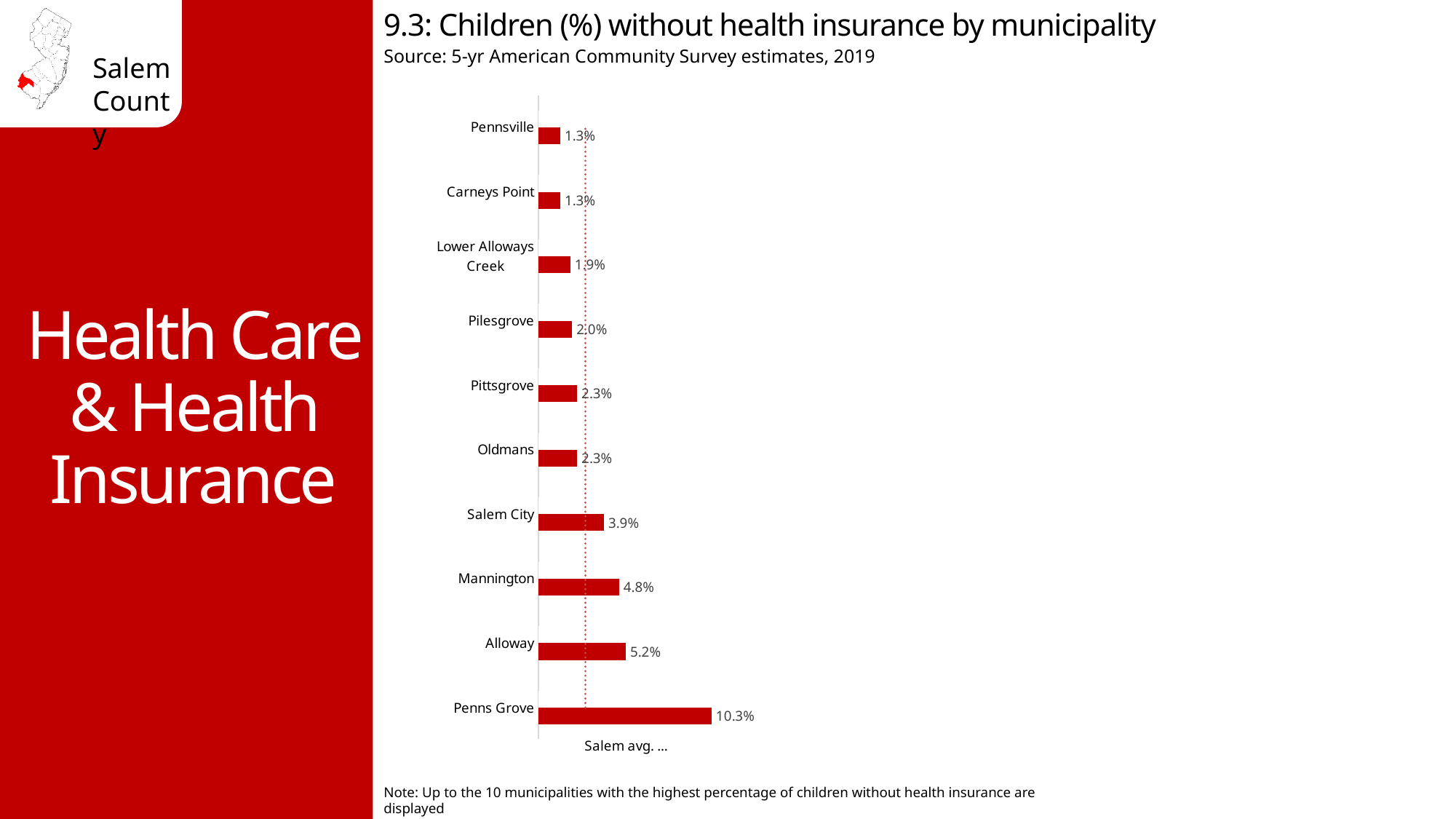
What percentage is shown for Salem City? 3.9% What is the title of the chart? 9.3: Children (%) without health insurance by municipality What does the dotted vertical line in the chart represent? Salem avg. What is the value for Lower Alloways Creek? 1.9% What is the value shown for Mannington? 4.8% What type of chart is shown on the slide? Bar chart What percentage of children in Penns Grove are without health insurance? 10.3% Which has a higher value, Alloway or Pittsgrove? Alloway What is the difference between the values for Penns Grove and Alloway? 5.1% What is the difference between the values for Mannington and Salem City? 0.9% Which municipality has the highest percentage of children without health insurance? Penns Grove How many municipalities are shown in the chart? 10